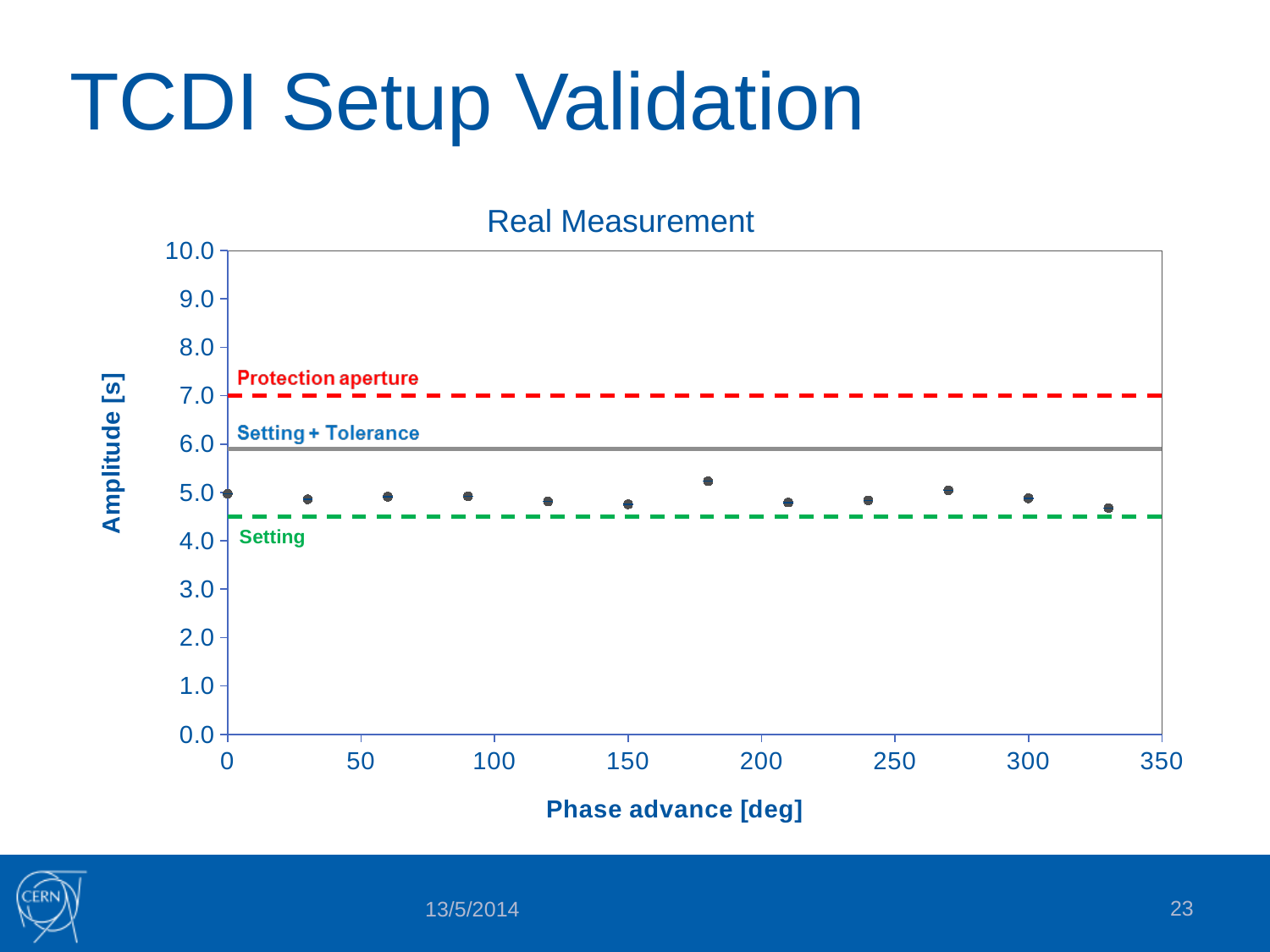
Do the measured amplitudes rise, fall, or stay roughly flat as phase advance increases? roughly flat Is the measured amplitude at a phase advance of 150 deg greater or less than 5.0? less Is the measured amplitude at a phase advance of 330 deg greater or less than 5.0? less What is the title of the chart? Real Measurement At what amplitude is the Protection aperture line drawn? 7.0 What is the label of the x axis? Phase advance [deg] What kind of chart is shown on the slide? scatter chart How many measured data points are plotted in the chart? 12 Is the measured amplitude at a phase advance of 180 deg greater or less than 5.0? greater Which is larger, the measured amplitude at 180 deg or at 330 deg? 180 deg At which phase advance is the measured amplitude highest? 180